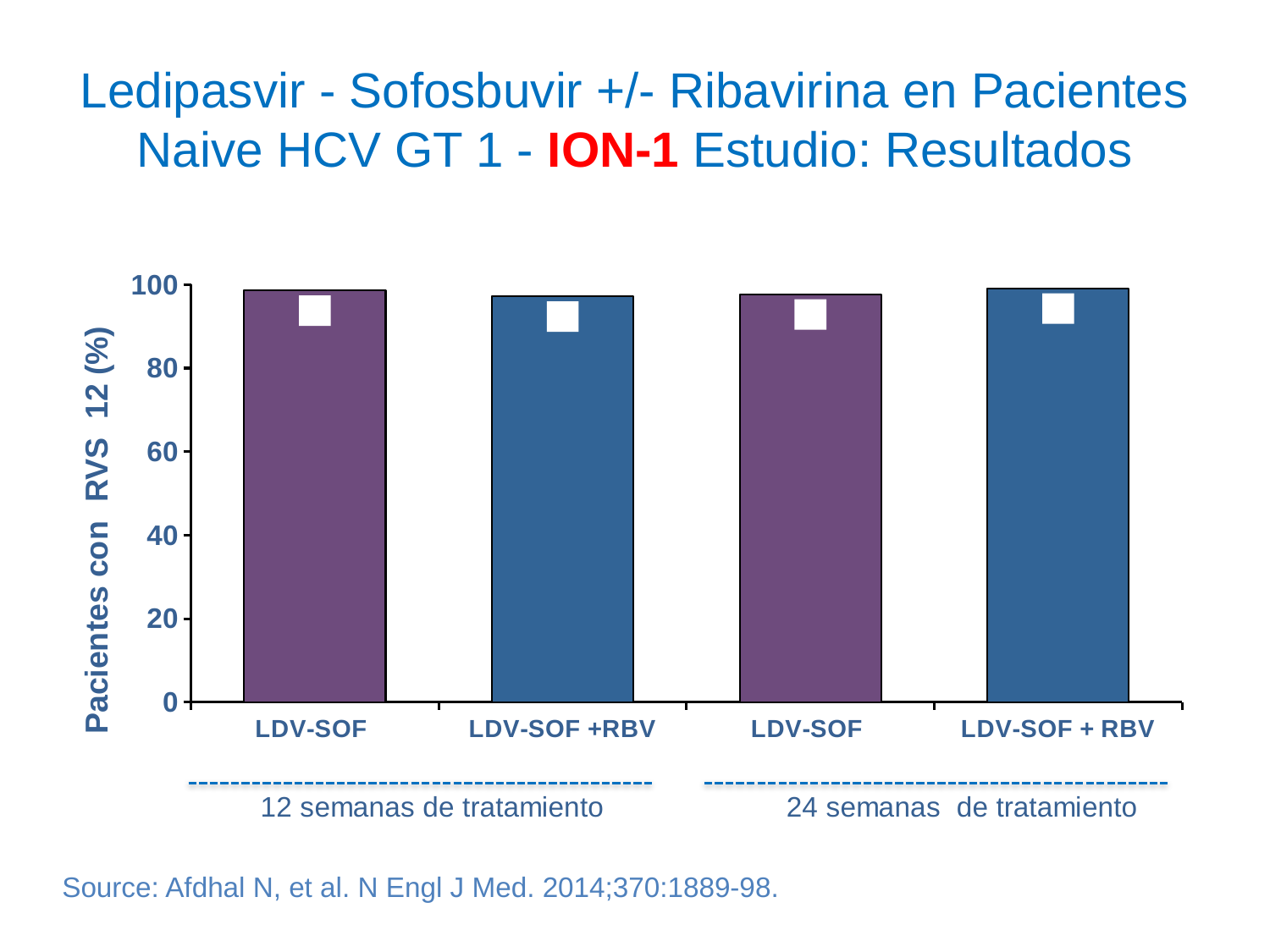
Is the value for LDV-SOF +RBV at 12 semanas de tratamiento greater or less than 90? greater Is the value for LDV-SOF + RBV at 24 semanas de tratamiento greater or less than 60? greater What kind of chart is shown on the slide? bar chart What is the label of the y axis of the chart? Pacientes con RVS 12 (%) Are all four bars in the chart above or below 90 on the y axis? above How many bars belong to the 24 semanas de tratamiento group? 2 How many bars are plotted in the chart? 4 What is the highest tick value shown on the y axis? 100 What are the two treatment-duration groups shown beneath the x axis? 12 semanas de tratamiento and 24 semanas de tratamiento